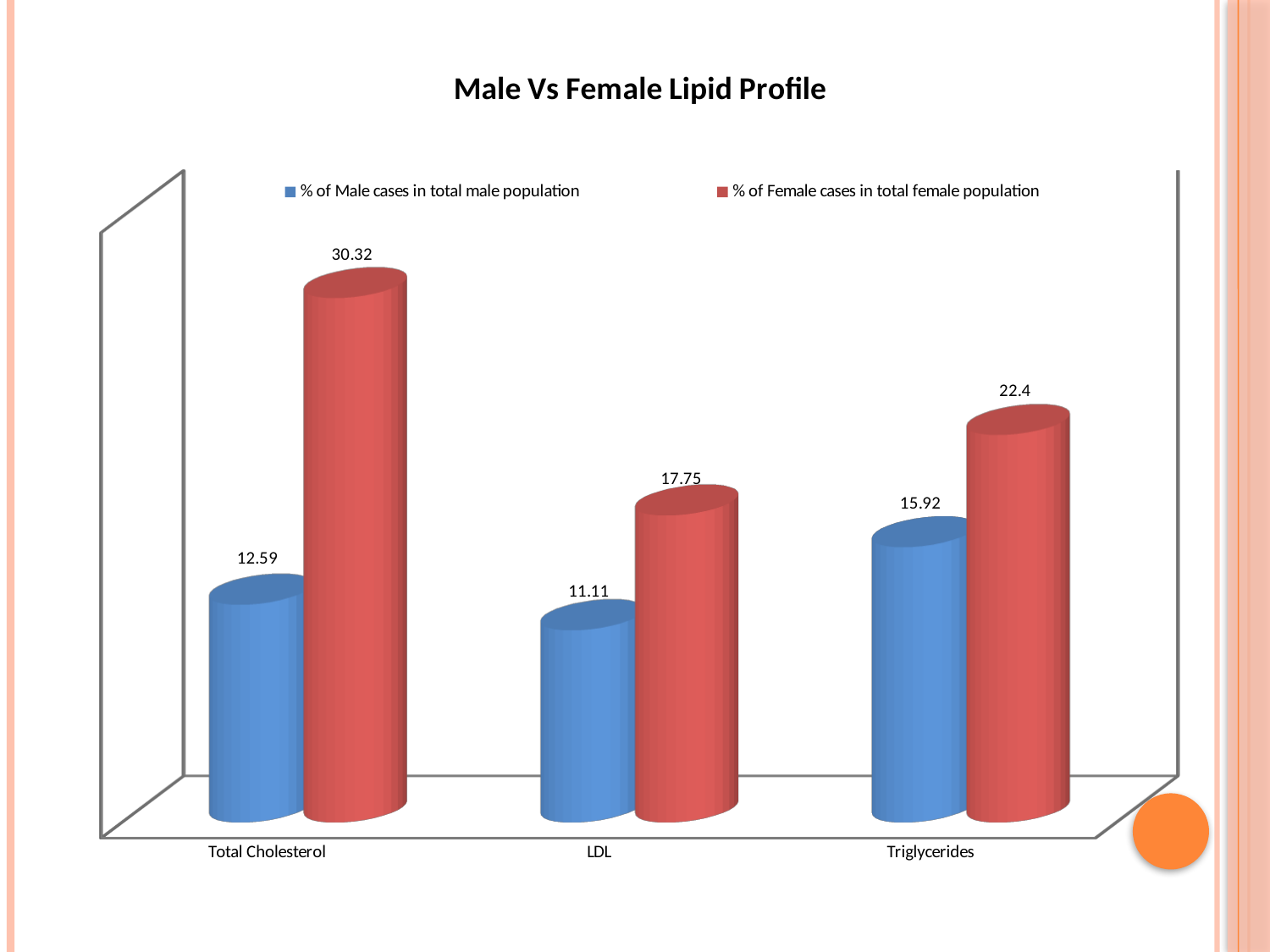
How many categories are shown on the x axis? 3 Which is larger for Triglycerides: the male value or the female value? the female value What is the value for % of Male cases in total male population for Total Cholesterol? 12.59 What is the value for % of Male cases in total male population for LDL? 11.11 What is the difference between the female and male values for Total Cholesterol? 17.73 Which category has the highest value for % of Female cases in total female population? Total Cholesterol Which category has the lowest value for % of Male cases in total male population? LDL How many series does the legend list? 2 What is the title of the chart? Male Vs Female Lipid Profile What is the value for % of Female cases in total female population for LDL? 17.75 What is the value for % of Female cases in total female population for Triglycerides? 22.4 What kind of chart is shown on the slide? bar chart